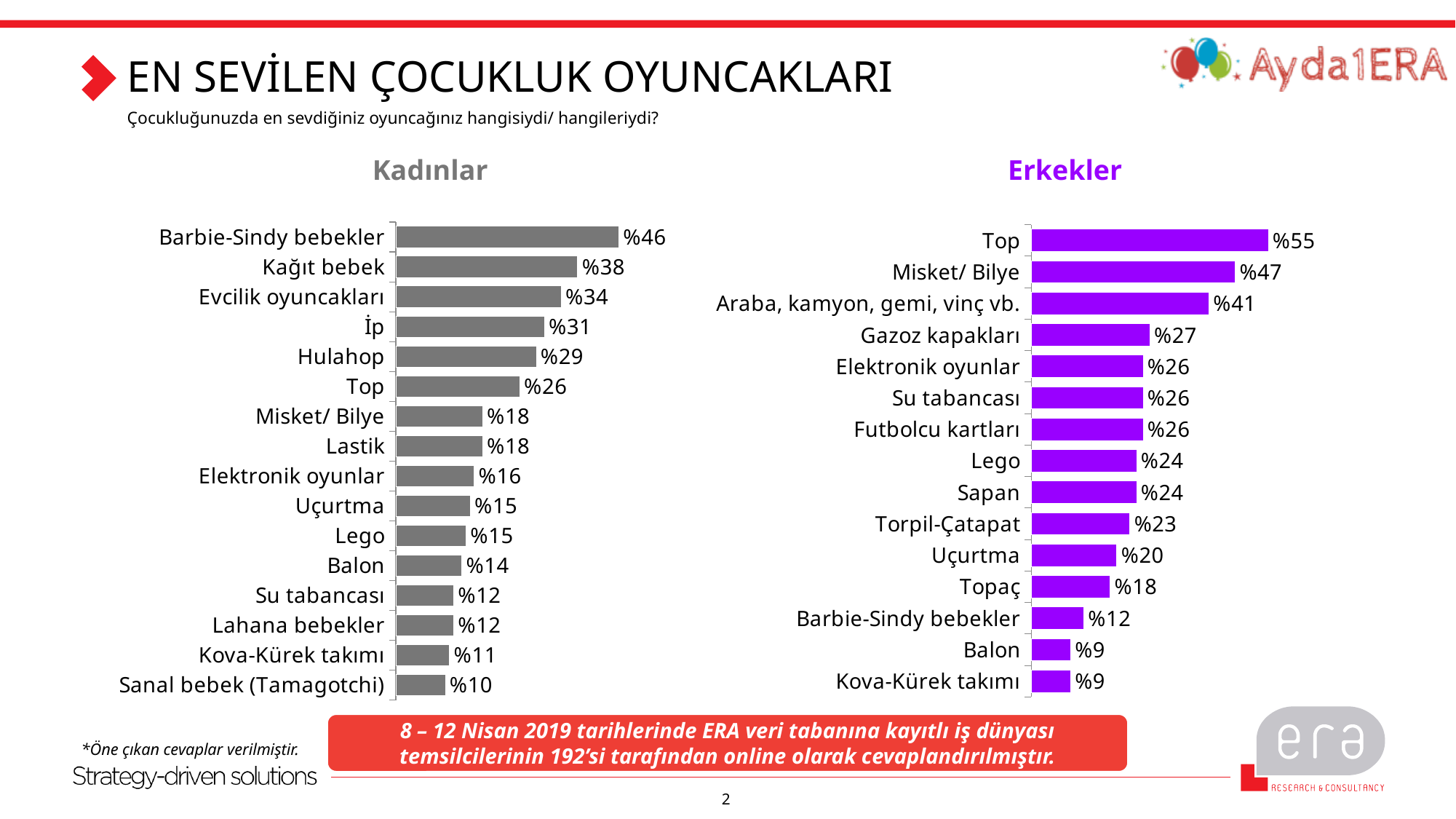
In the Kadınlar chart, what is the difference between Kağıt bebek and Evcilik oyuncakları? 4 percentage points In the Kadınlar chart, what is the value for Lego? %15 In the Kadınlar chart, which category has the lowest value? Sanal bebek (Tamagotchi) How many categories are shown in the Kadınlar chart? 16 What kind of chart is the Erkekler chart? Bar chart In the Erkekler chart, which category has the highest value? Top In the Erkekler chart, what is the difference between Top and Araba, kamyon, gemi, vinç vb.? 14 percentage points How many categories are shown in the Erkekler chart? 15 In the Kadınlar chart, what is the value for Barbie-Sindy bebekler? %46 In the Erkekler chart, which is larger: Gazoz kapakları or Uçurtma? Gazoz kapakları In the Erkekler chart, what is the value for Misket/ Bilye? %47 In the Kadınlar chart, which is larger: Hulahop or Top? Hulahop